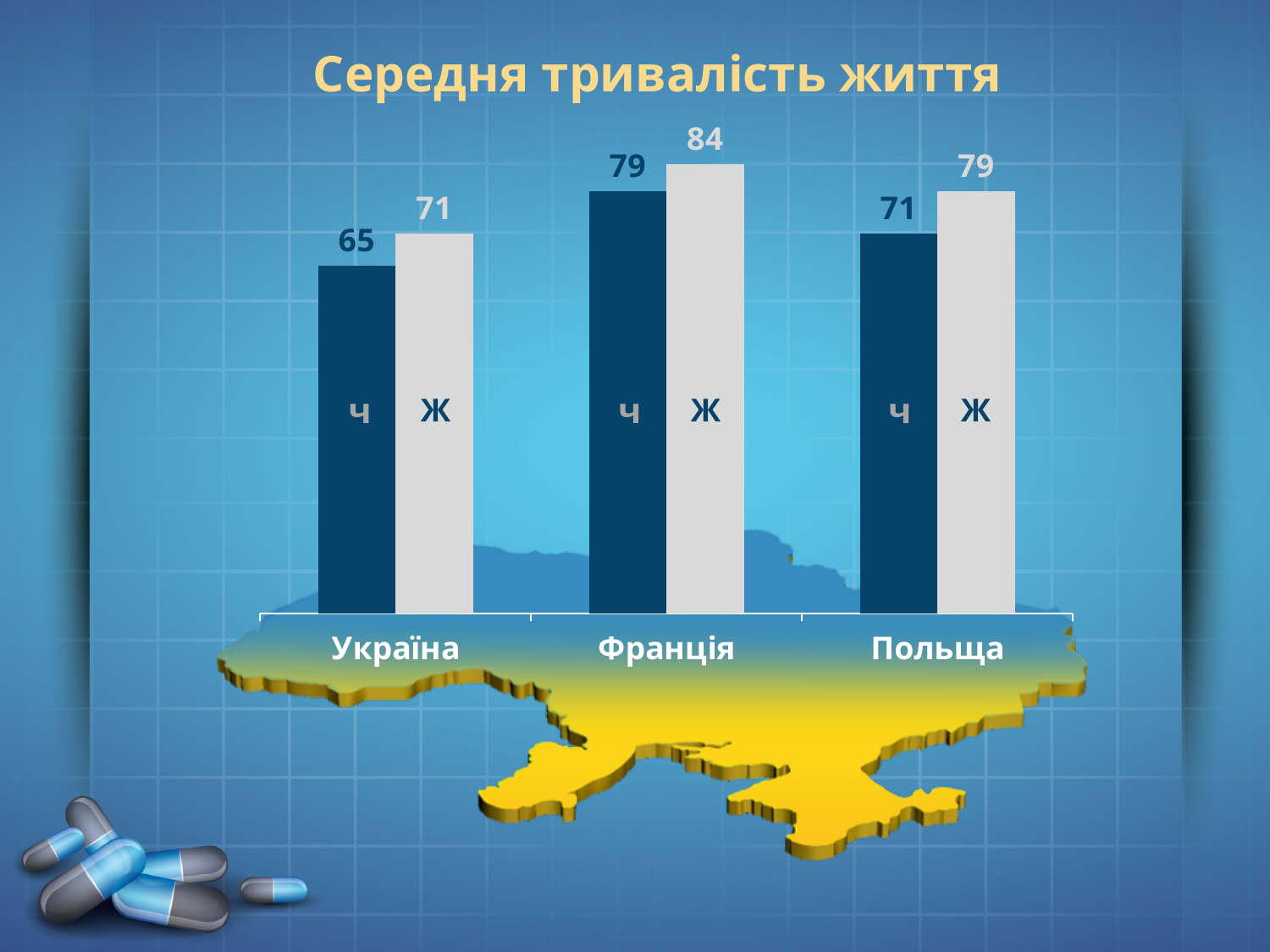
Which is larger: the Ж value for Україна or the Ч value for Франція? Ч value for Франція What is the value for Ж (women) in Франція? 84 What is the value for Ж (women) in Україна? 71 What is the value for Ч (men) in Україна? 65 What is the value for Ч (men) in Польща? 71 What is the difference between the Ж and Ч values for Польща? 8 Which country has the lowest value for Ч (men)? Україна Which country has the highest value for Ж (women)? Франція What is the difference between the Ч values for Франція and Україна? 14 What is the title of the chart? Середня тривалість життя What kind of chart is shown on the slide? Bar chart How many countries are shown on the chart? 3